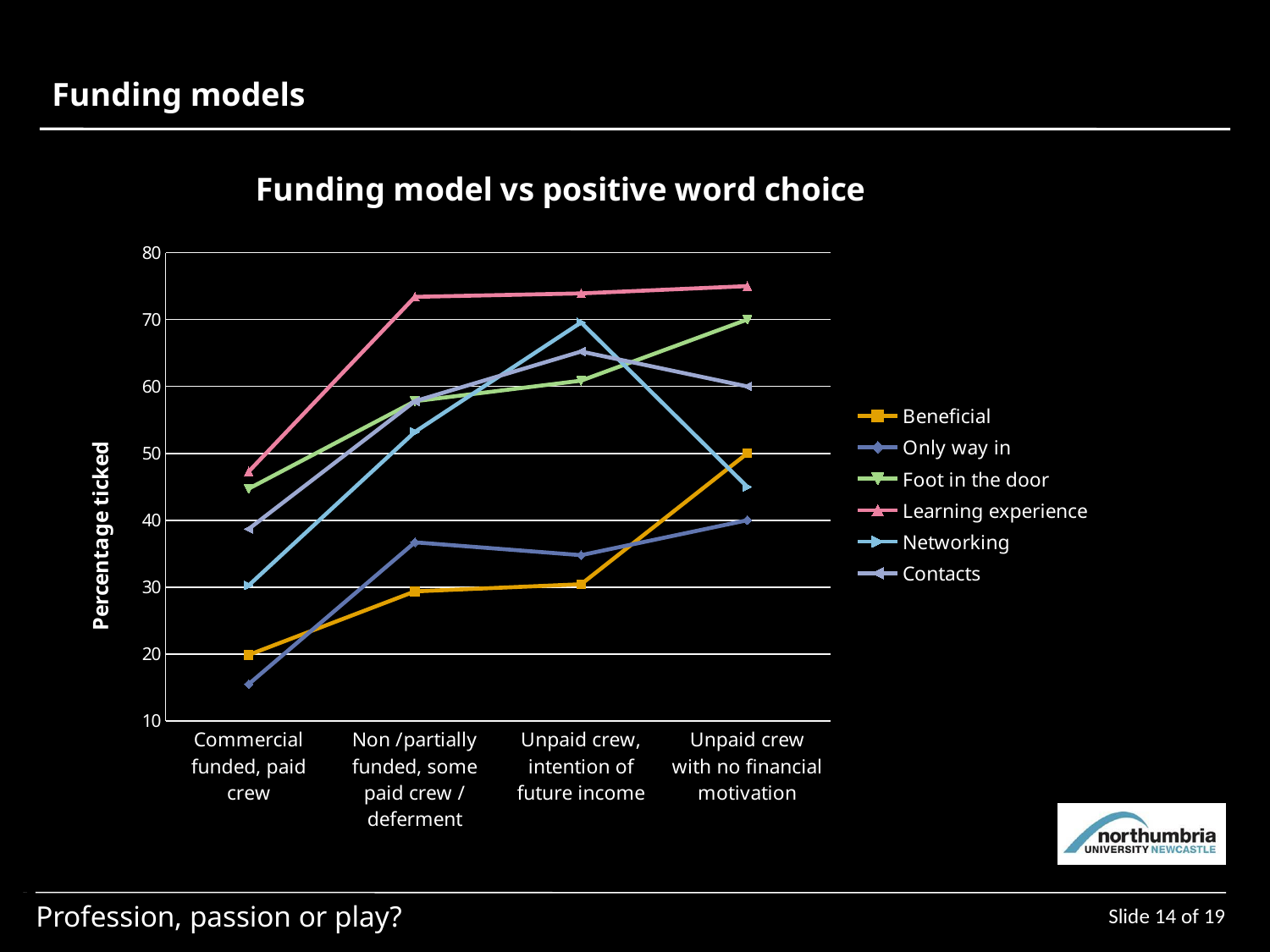
What is the title of the y axis? Percentage ticked What is the value for Beneficial at 'Unpaid crew with no financial motivation'? 50 Does the Learning experience line rise or fall from left to right across the x axis? rises Which series has the lowest value for 'Commercial funded, paid crew'? Only way in Is the value for Beneficial at 'Unpaid crew, intention of future income' greater or less than 40? less Is the value for Networking at 'Unpaid crew, intention of future income' greater or less than 60? greater Is the value for Learning experience at 'Non /partially funded, some paid crew / deferment' greater or less than 70? greater How many funding model categories are shown on the x axis? 4 At 'Unpaid crew with no financial motivation', which is larger: Beneficial or Networking? Beneficial Which series has the highest value for 'Unpaid crew with no financial motivation'? Learning experience How many series does the legend list? 6 What kind of chart is shown on the slide? line chart